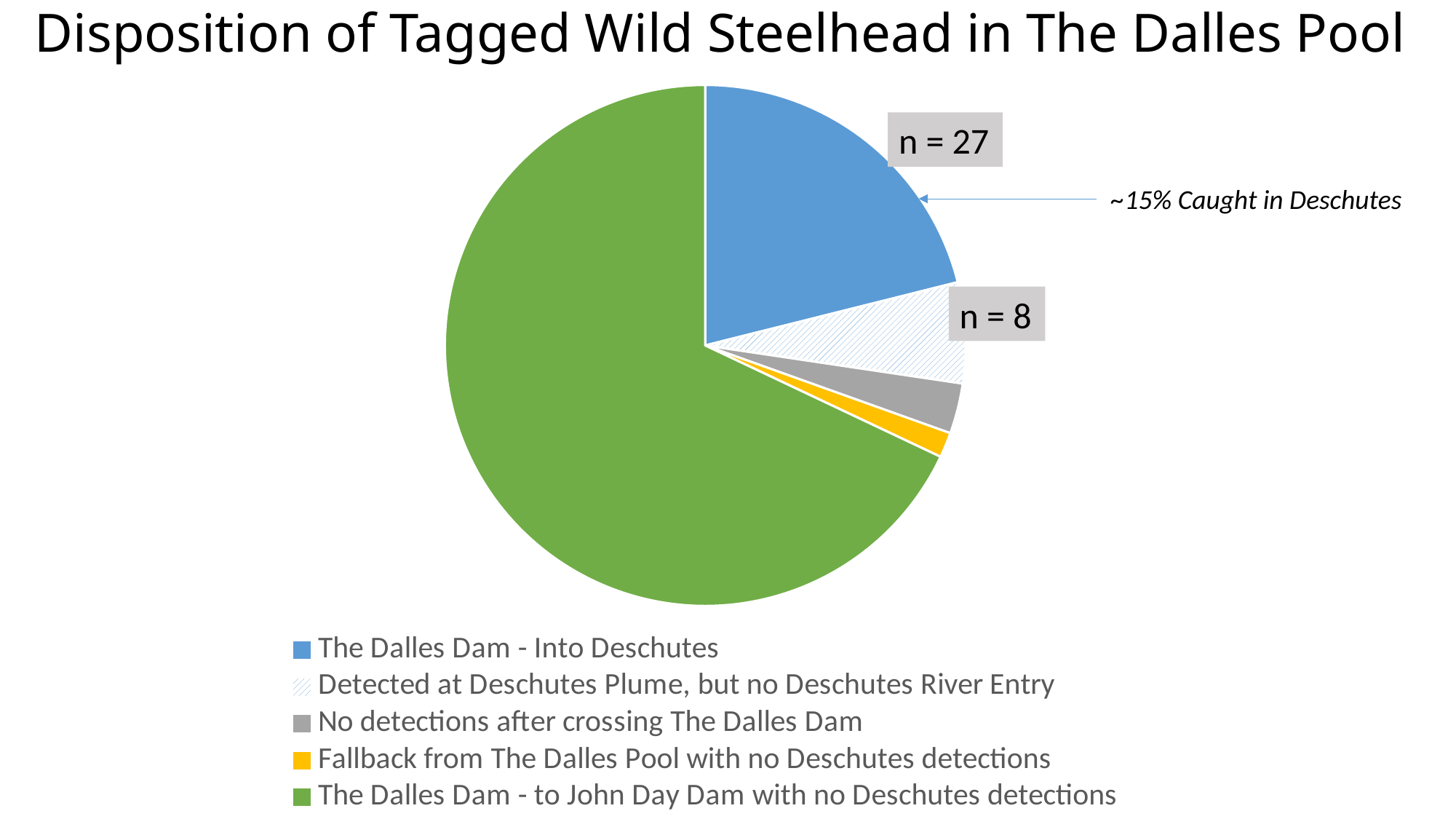
What kind of chart is shown on the slide? pie chart Which is larger: the 'No detections after crossing The Dalles Dam' slice or the 'Fallback from The Dalles Pool with no Deschutes detections' slice? No detections after crossing The Dalles Dam What is the n value labelled for the 'The Dalles Dam - Into Deschutes' slice? n = 27 What is the n value labelled for the 'Detected at Deschutes Plume, but no Deschutes River Entry' slice? n = 8 Which category has the largest slice of the pie? The Dalles Dam - to John Day Dam with no Deschutes detections Which is larger: the 'The Dalles Dam - Into Deschutes' slice or the 'Detected at Deschutes Plume, but no Deschutes River Entry' slice? The Dalles Dam - Into Deschutes How many slices does the pie chart have? 5 How many entries does the legend list? 5 What is the title of the chart? Disposition of Tagged Wild Steelhead in The Dalles Pool What does the annotation pointing to the blue slice say? ~15% Caught in Deschutes What is the difference between the n values labelled for 'The Dalles Dam - Into Deschutes' and 'Detected at Deschutes Plume, but no Deschutes River Entry'? 19 Which category has the smallest slice of the pie? Fallback from The Dalles Pool with no Deschutes detections